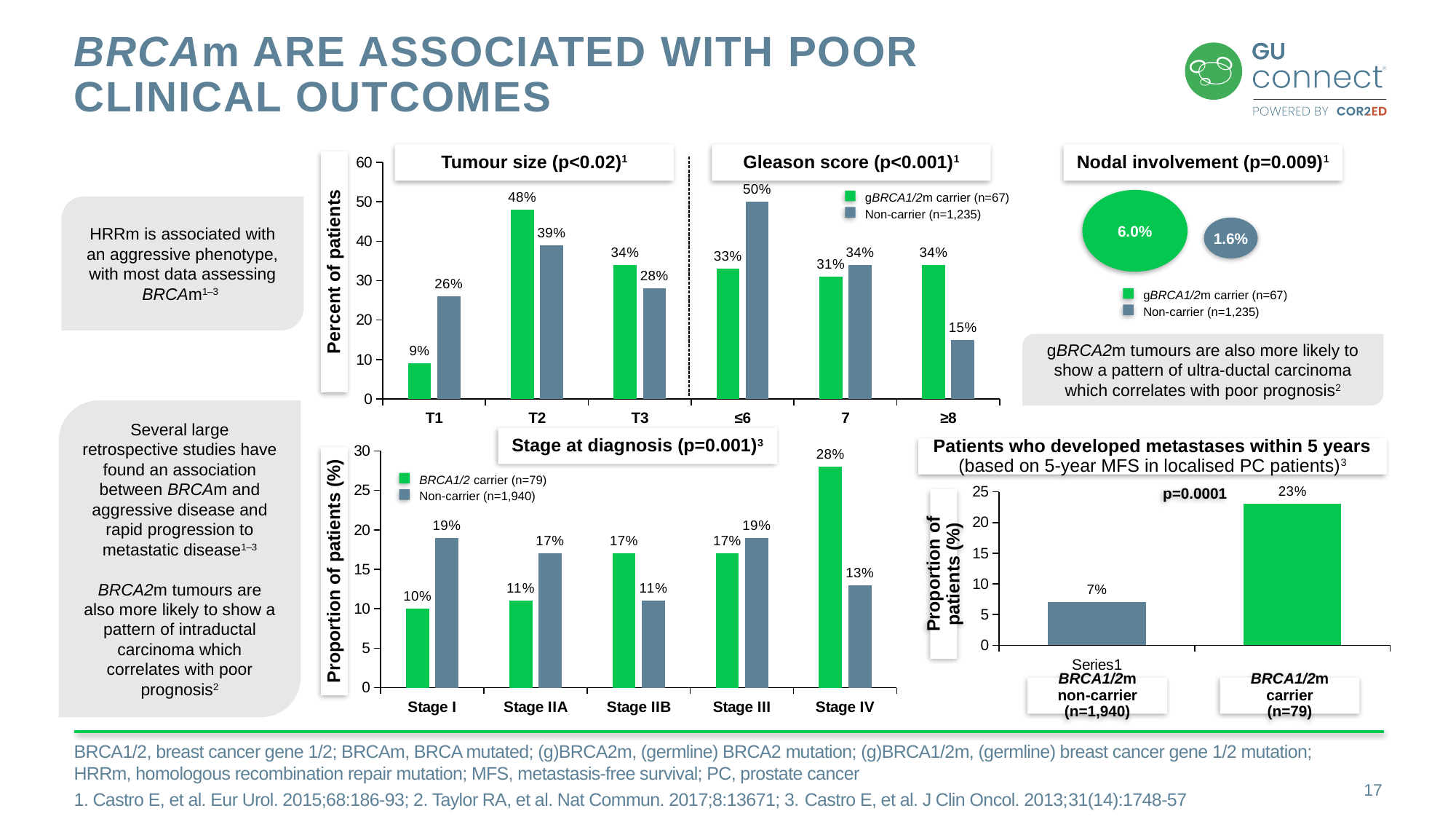
In the Tumour size chart, which tumour size category has the lowest value for gBRCA1/2m carriers? T1 In the Gleason score chart, what is the value for non-carriers at ≤6? 50% In the Tumour size chart, what is the value for gBRCA1/2m carriers at T2? 48% In the Tumour size chart, what is the value for non-carriers at T1? 26% In the Patients who developed metastases within 5 years chart, what is the difference between BRCA1/2m carriers and non-carriers? 16% In the Nodal involvement chart, what is the value for non-carriers? 1.6% In the Patients who developed metastases within 5 years chart, what is the value for BRCA1/2m carriers? 23% In the Gleason score chart, what is the difference between gBRCA1/2m carriers and non-carriers at ≥8? 19% In the Stage at diagnosis chart, which stage has the highest value for BRCA1/2 carriers? Stage IV In the Stage at diagnosis chart, what is the value for BRCA1/2 carriers at Stage IV? 28% In the Stage at diagnosis chart, how many stage categories are shown on the x axis? 5 In the Stage at diagnosis chart, which is larger at Stage I: BRCA1/2 carriers or non-carriers? Non-carriers